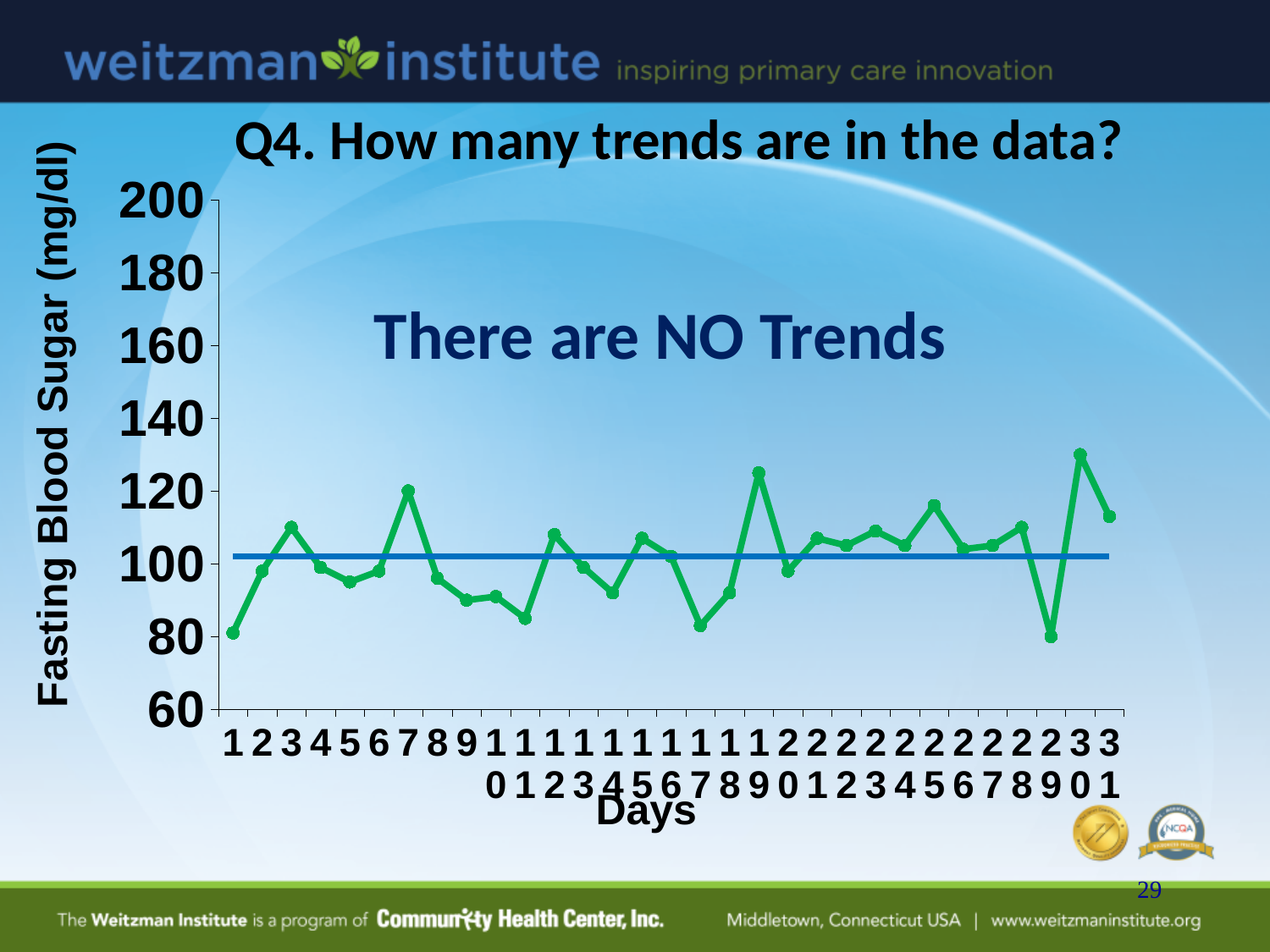
How many days are plotted along the x axis of the chart? 31 Which day has the larger fasting blood sugar value, day 29 or day 30? day 30 Which day has the larger fasting blood sugar value, day 19 or day 20? day 19 Is the fasting blood sugar value for day 19 greater or less than 120? greater Is the fasting blood sugar value for day 25 greater or less than 100? greater Is the fasting blood sugar value for day 1 greater or less than 100? less What is the label of the y axis of the chart? Fasting Blood Sugar (mg/dl) On which day is the fasting blood sugar value highest? 30 What kind of chart is shown on the slide? line chart What is the label of the x axis of the chart? Days